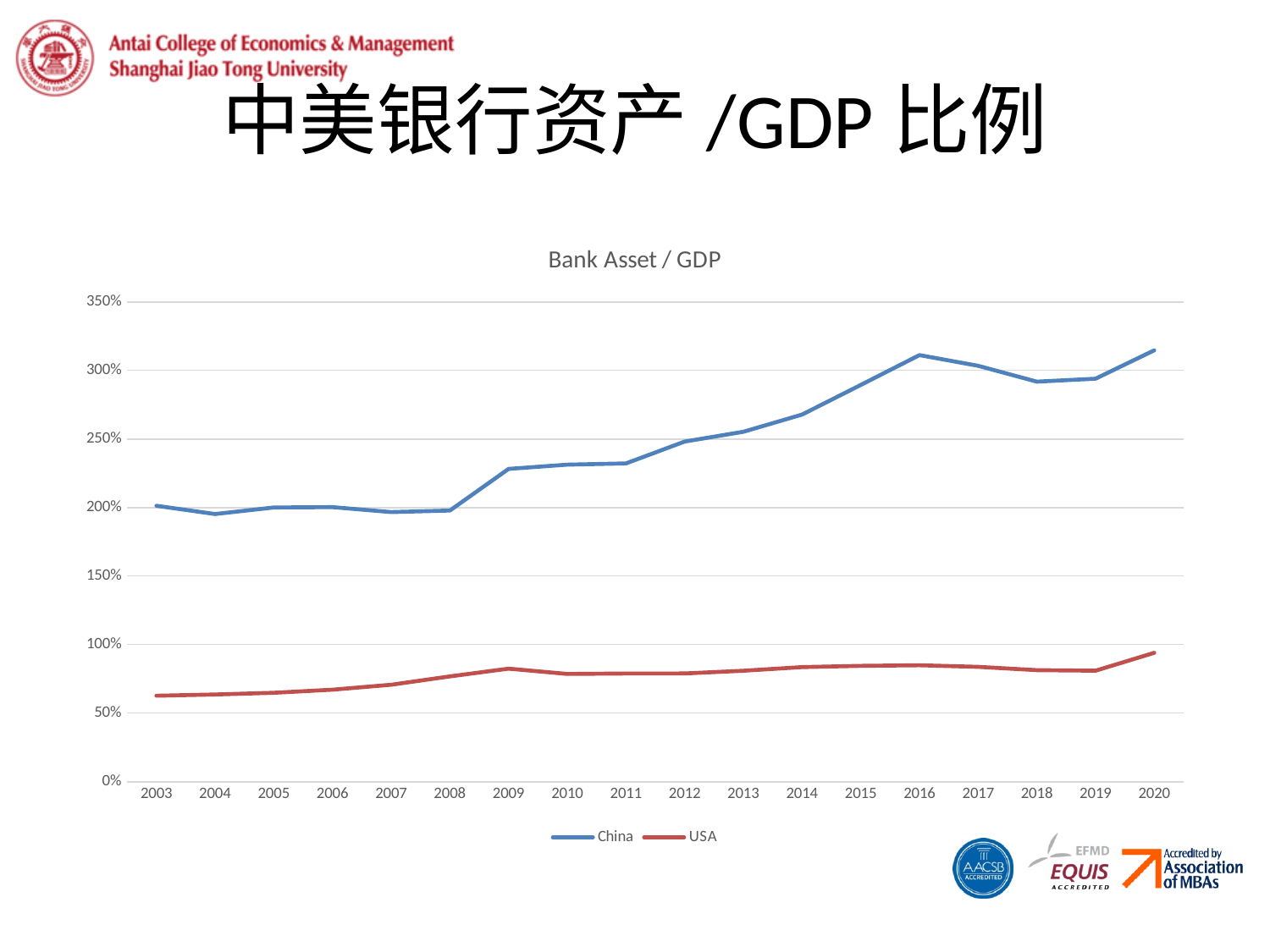
What is the title of the chart? Bank Asset / GDP Is the value for China in 2016 greater or less than 300%? greater What kind of chart is shown on the slide? line chart Is the value for China in 2018 greater or less than 300%? less How many series does the legend list? 2 Is the value for China in 2009 greater or less than 200%? greater Which series has the larger value in 2015, China or USA? China How many years are plotted along the x axis? 18 Which colour is used for the USA line? red Does the China line generally rise or fall from 2003 to 2020? rise In which year is the USA value highest? 2020